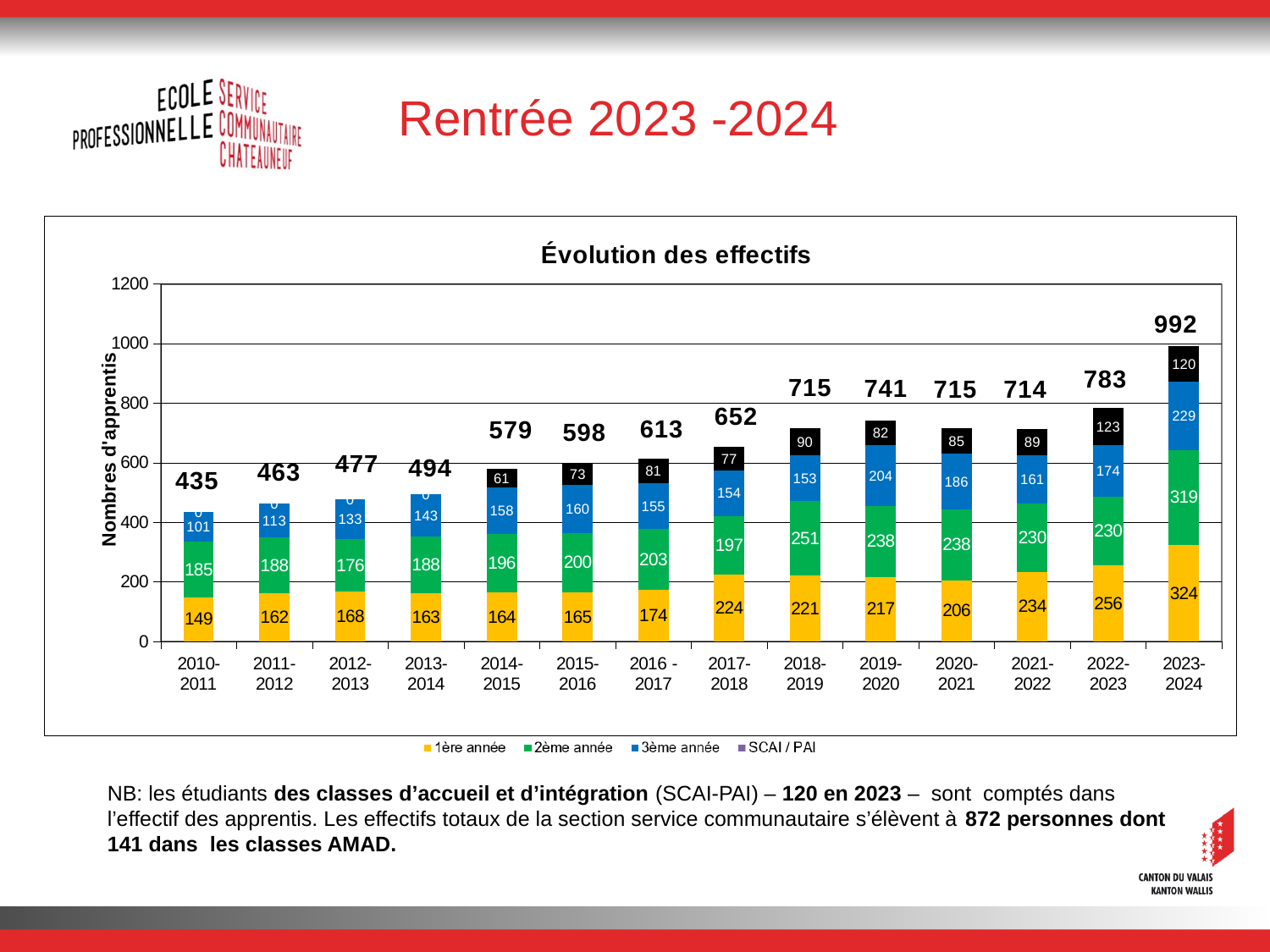
What is the value for 1ère année in 2023-2024? 324 How many school years are shown on the x axis of the chart? 14 What is the difference between the total for 2023-2024 and the total for 2022-2023? 209 What is the value for SCAI / PAI in 2020-2021? 85 What kind of chart is shown on the slide? Stacked bar chart Which is larger, the 2ème année value for 2018-2019 or for 2019-2020? 2018-2019 What is the title of the y axis of the chart? Nombres d'apprentis Which school year has the highest total number of apprentices? 2023-2024 Do the total numbers of apprentices rise or fall from 2010-2011 to 2017-2018? Rise What is the total number of apprentices shown above the bar for 2017-2018? 652 Which school year has the lowest total number of apprentices? 2010-2011 How many series does the legend of the chart list? 4